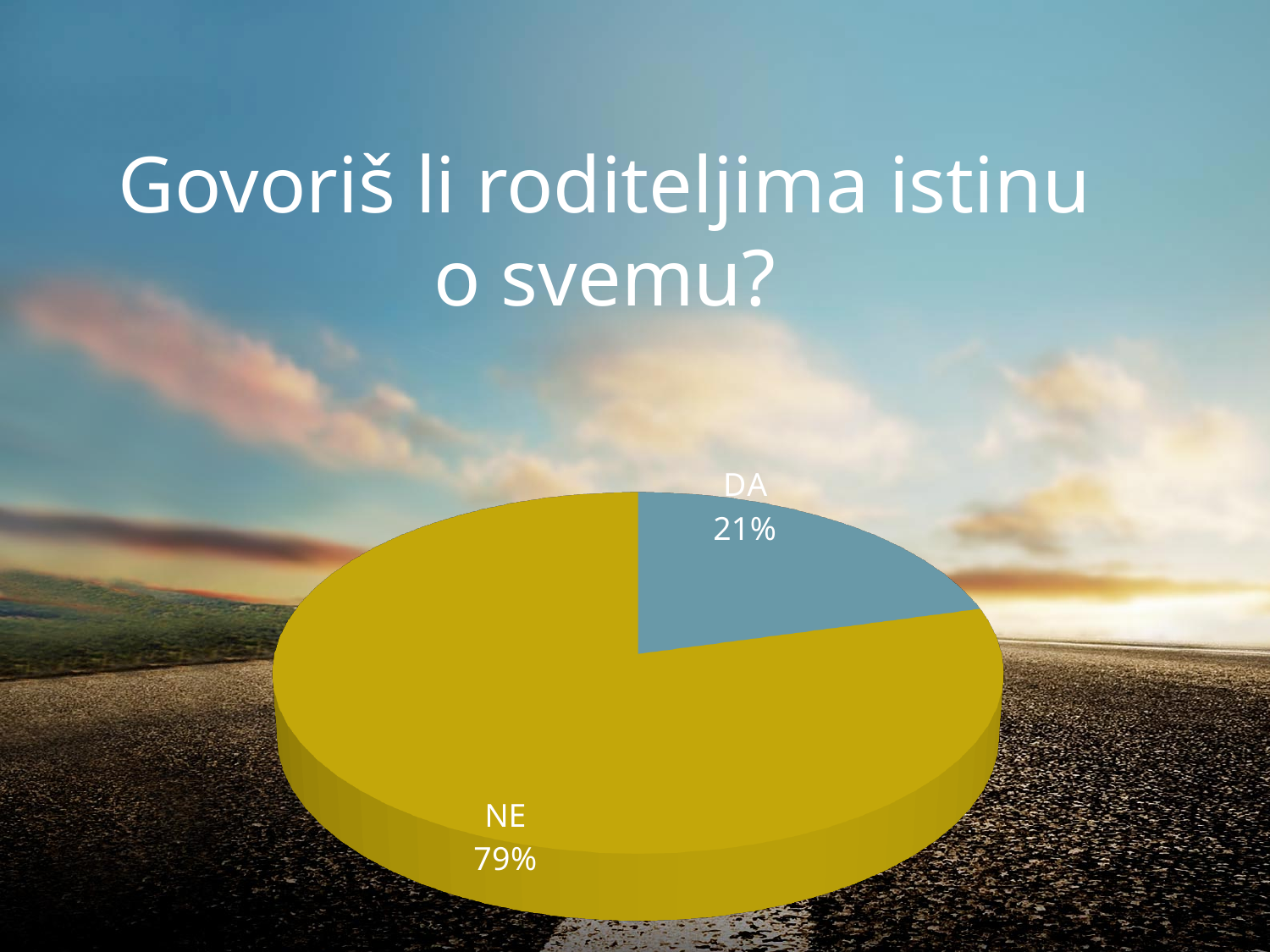
What percentage of respondents answered DA? 21% Which slice is larger, DA or NE? NE Which answer has the largest share of the pie? NE What is the difference in percentage points between the NE and DA slices? 58 What colour is the NE slice of the pie chart? yellow What share of the pie does the DA slice represent? 21% What is the title of the slide above the chart? Govoriš li roditeljima istinu o svemu? Which answer has the smallest share of the pie? DA How many slices does the pie chart have? 2 What percentage of respondents answered NE? 79% What kind of chart is shown on the slide? pie chart